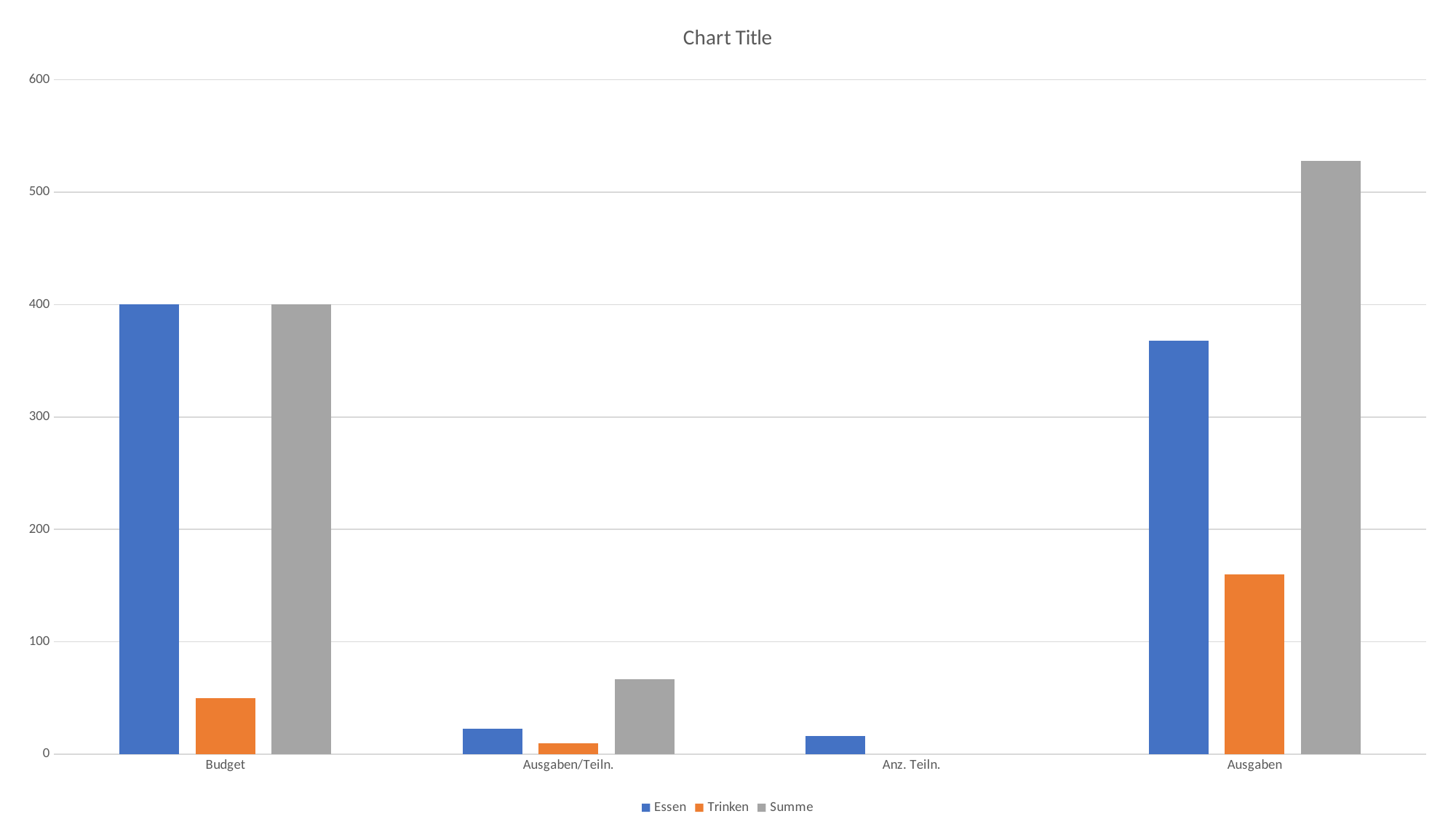
Which is larger, the Essen value for Budget or the Essen value for Ausgaben? Budget What kind of chart is shown on the slide? bar chart Which category has the highest Summe value? Ausgaben What is the value of Essen for Budget? 400 What is the title of the chart? Chart Title How many categories are shown on the x axis? 4 What is the value of Summe for Budget? 400 How many series does the legend list? 3 Is the value of Essen for Ausgaben greater or less than 400? less Is the value of Trinken for Ausgaben greater or less than 100? greater Is the value of Trinken for Budget greater or less than 100? less